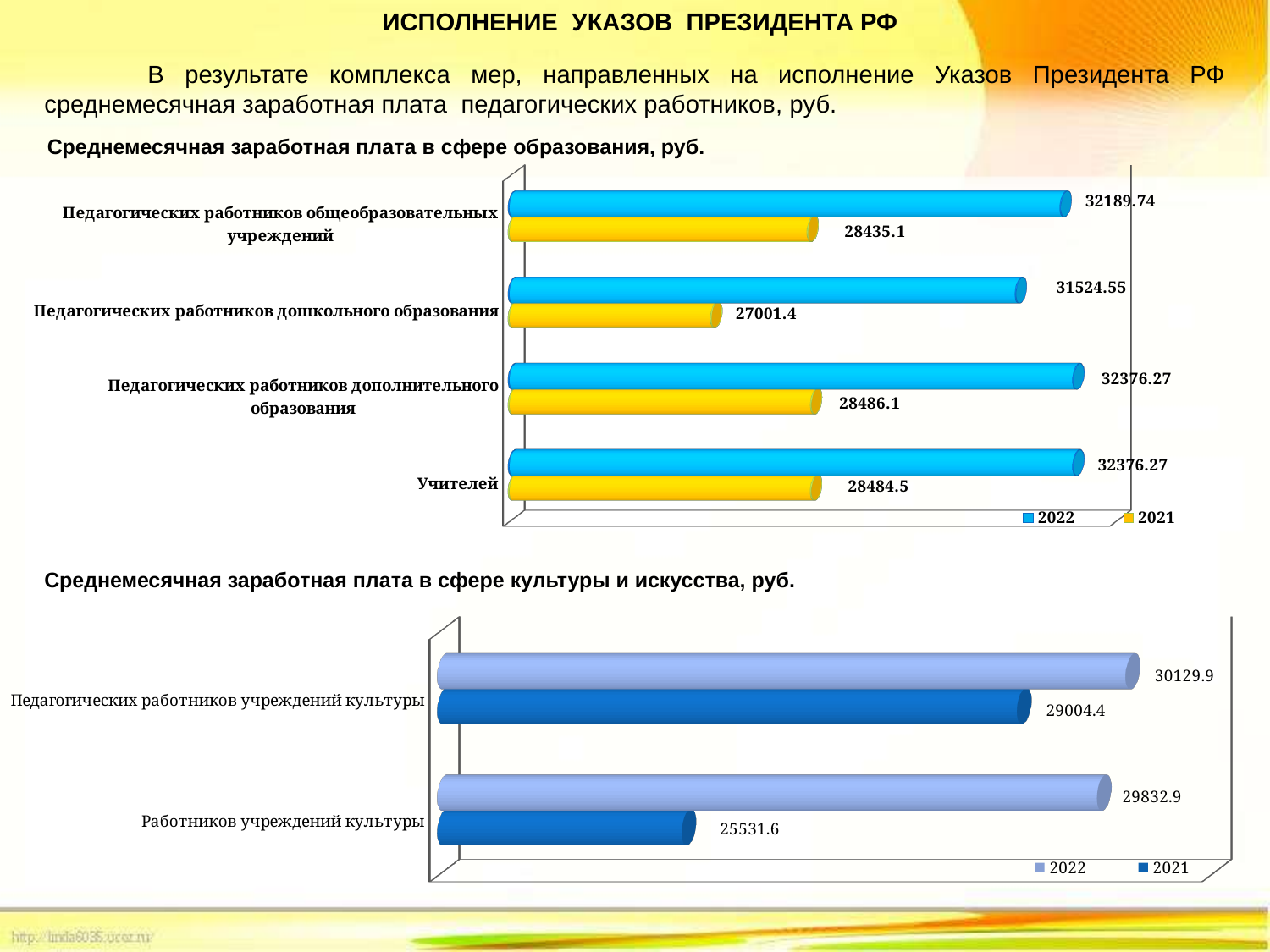
What type of chart is 'Среднемесячная заработная плата в сфере культуры и искусства, руб.'? Bar chart In the chart 'Среднемесячная заработная плата в сфере культуры и искусства, руб.', what is the 2021 value for Работников учреждений культуры? 25531.6 In the chart 'Среднемесячная заработная плата в сфере образования, руб.', what is the difference between the 2022 and 2021 values for Педагогических работников общеобразовательных учреждений? 3754.64 In the chart 'Среднемесячная заработная плата в сфере образования, руб.', how many categories are shown? 4 In the chart 'Среднемесячная заработная плата в сфере образования, руб.', what is the 2022 value for Педагогических работников общеобразовательных учреждений? 32189.74 In the chart 'Среднемесячная заработная плата в сфере образования, руб.', what is the 2021 value for Педагогических работников дошкольного образования? 27001.4 In the chart 'Среднемесячная заработная плата в сфере образования, руб.', which category has the lowest 2021 value? Педагогических работников дошкольного образования In the chart 'Среднемесячная заработная плата в сфере культуры и искусства, руб.', what is the difference between the 2022 and 2021 values for Работников учреждений культуры? 4301.3 In the chart 'Среднемесячная заработная плата в сфере образования, руб.', what is the 2021 value for Учителей? 28484.5 In the chart 'Среднемесячная заработная плата в сфере образования, руб.', which category has the lowest 2022 value? Педагогических работников дошкольного образования In the chart 'Среднемесячная заработная плата в сфере образования, руб.', how many series does the legend list? 2 In the chart 'Среднемесячная заработная плата в сфере культуры и искусства, руб.', what is the 2022 value for Педагогических работников учреждений культуры? 30129.9